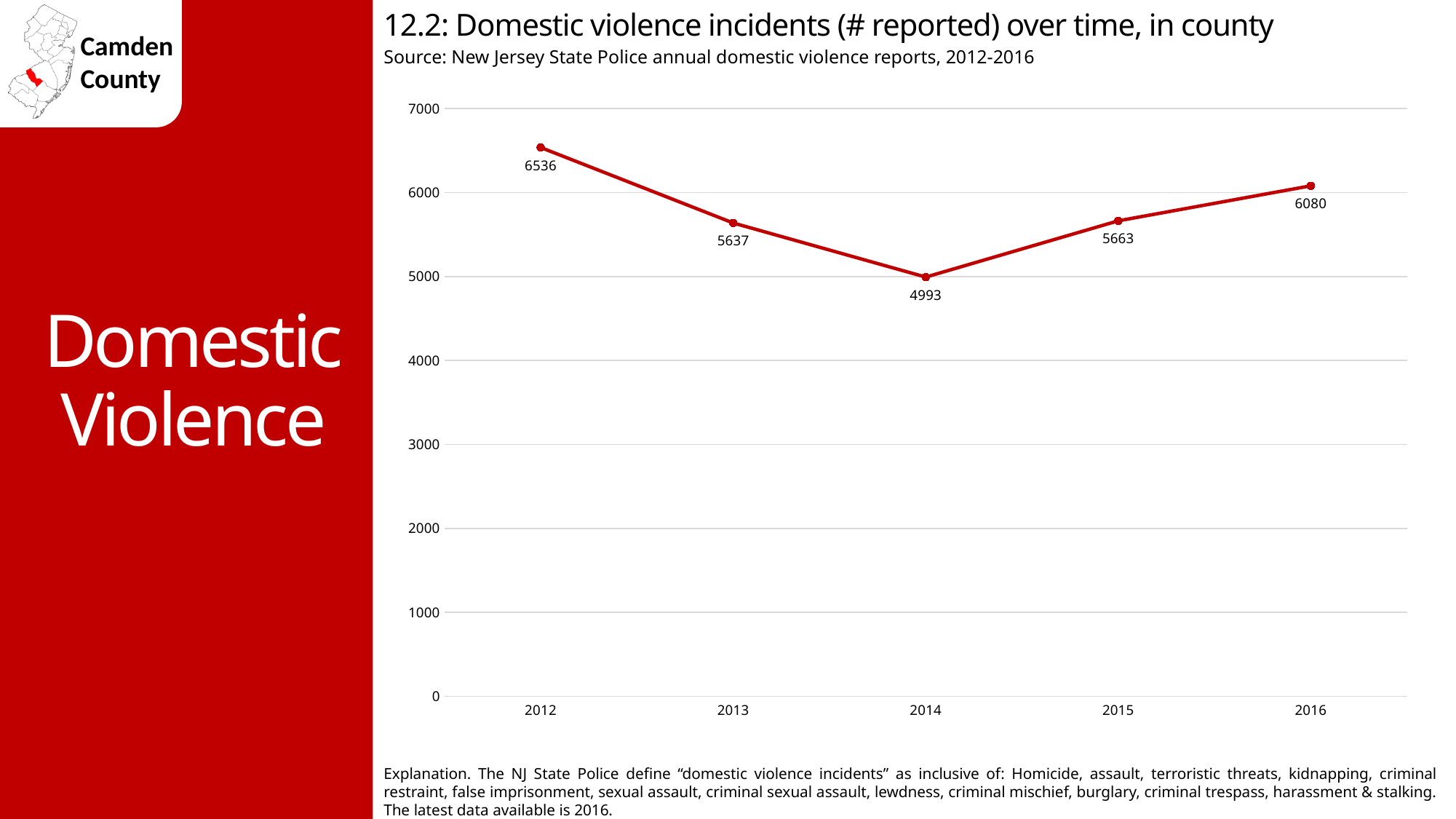
Do the values rise or fall from 2012 to 2014? fall What is the value plotted for 2014? 4993 Which year has the highest number of reported incidents? 2012 What kind of chart is shown on the slide? line chart Which year has the lowest number of reported incidents? 2014 Which year had more reported incidents, 2013 or 2016? 2016 How many domestic violence incidents were reported in 2012? 6536 How many incidents were reported in 2016? 6080 What is the difference between the 2012 and 2014 values? 1543 How many years are plotted on the chart? 5 Is the value for 2015 greater or less than 5000? greater By how much did the number of incidents increase from 2015 to 2016? 417